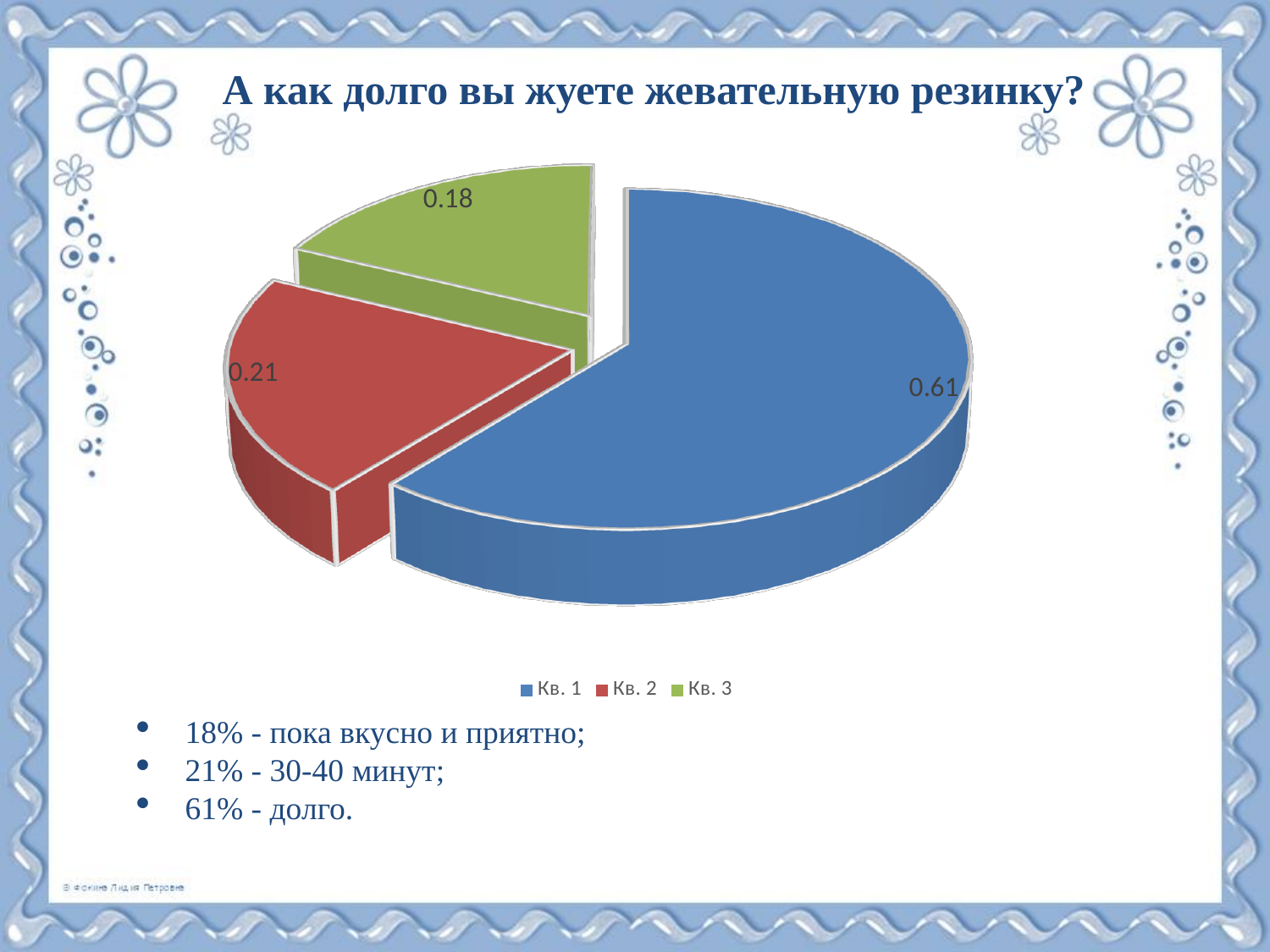
What is the value shown for the Кв. 1 slice? 0.61 What is the difference between the values for Кв. 1 and Кв. 2? 0.40 Which slice of the pie chart is the largest? Кв. 1 What type of chart is shown on the slide? pie chart What is the value shown for the Кв. 2 slice? 0.21 What colour is the Кв. 2 slice in the pie chart? red What is the difference between the values for Кв. 2 and Кв. 3? 0.03 Which is larger, the value for Кв. 1 or the value for Кв. 3? Кв. 1 How many entries does the legend list? 3 Which slice of the pie chart is the smallest? Кв. 3 What is the value shown for the Кв. 3 slice? 0.18 How many slices does the pie chart have? 3